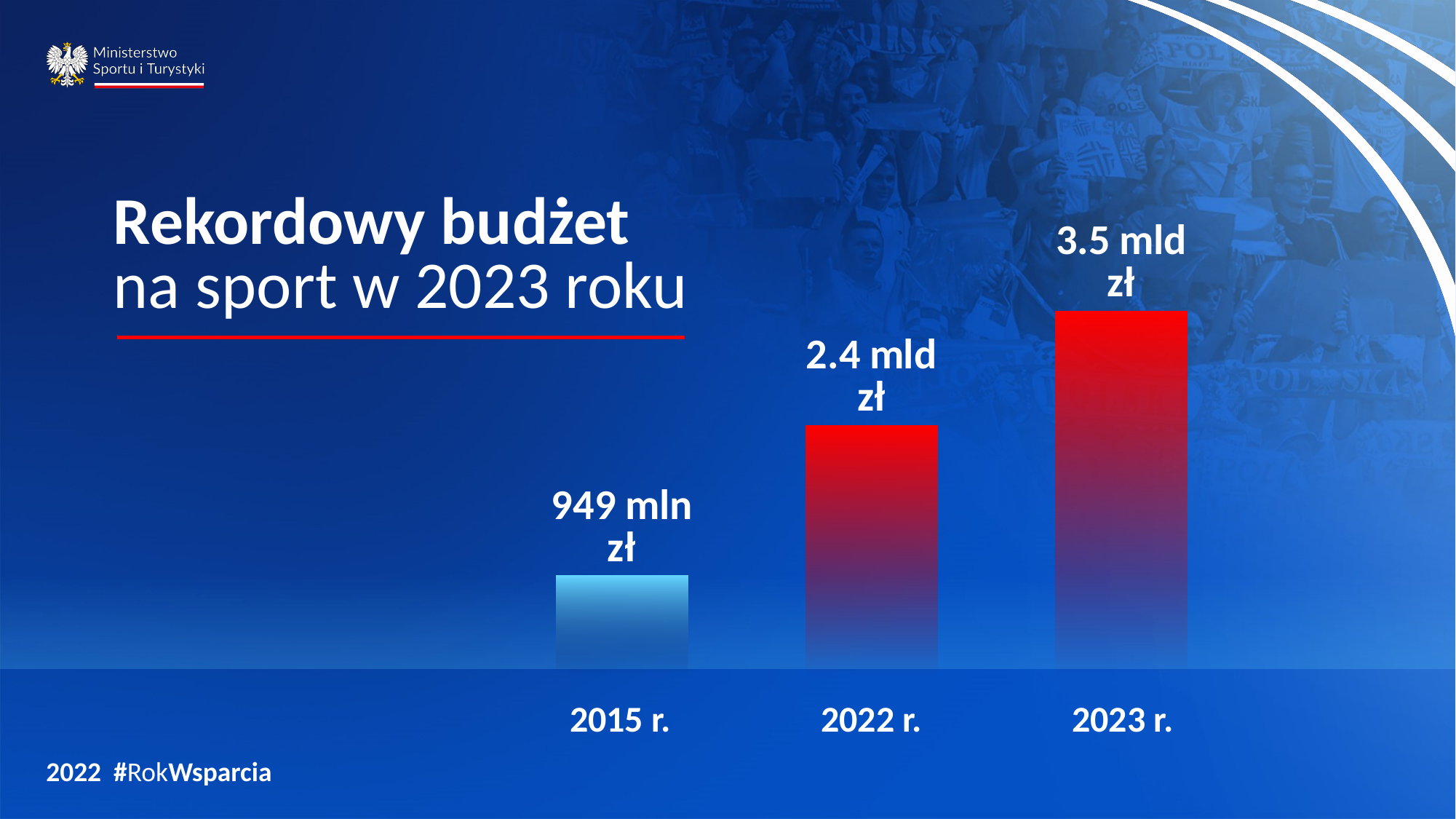
Which year has the highest budget value on the chart? 2023 r. What is the sport budget value shown for 2023 r.? 3.5 mld zł What is the sport budget value shown for 2015 r.? 949 mln zł Do the budget values rise or fall from 2015 r. to 2023 r.? Rise Which year has the lowest budget value on the chart? 2015 r. Which is larger, the budget for 2022 r. or for 2015 r.? 2022 r. What kind of chart is shown on the slide? Bar chart How many years (bars) are shown on the chart? 3 What is the title of the slide containing the chart? Rekordowy budżet na sport w 2023 roku What is the sport budget value shown for 2022 r.? 2.4 mld zł What colour is the bar for 2015 r.? Blue By how much does the 2023 r. budget exceed the 2022 r. budget? 1.1 mld zł